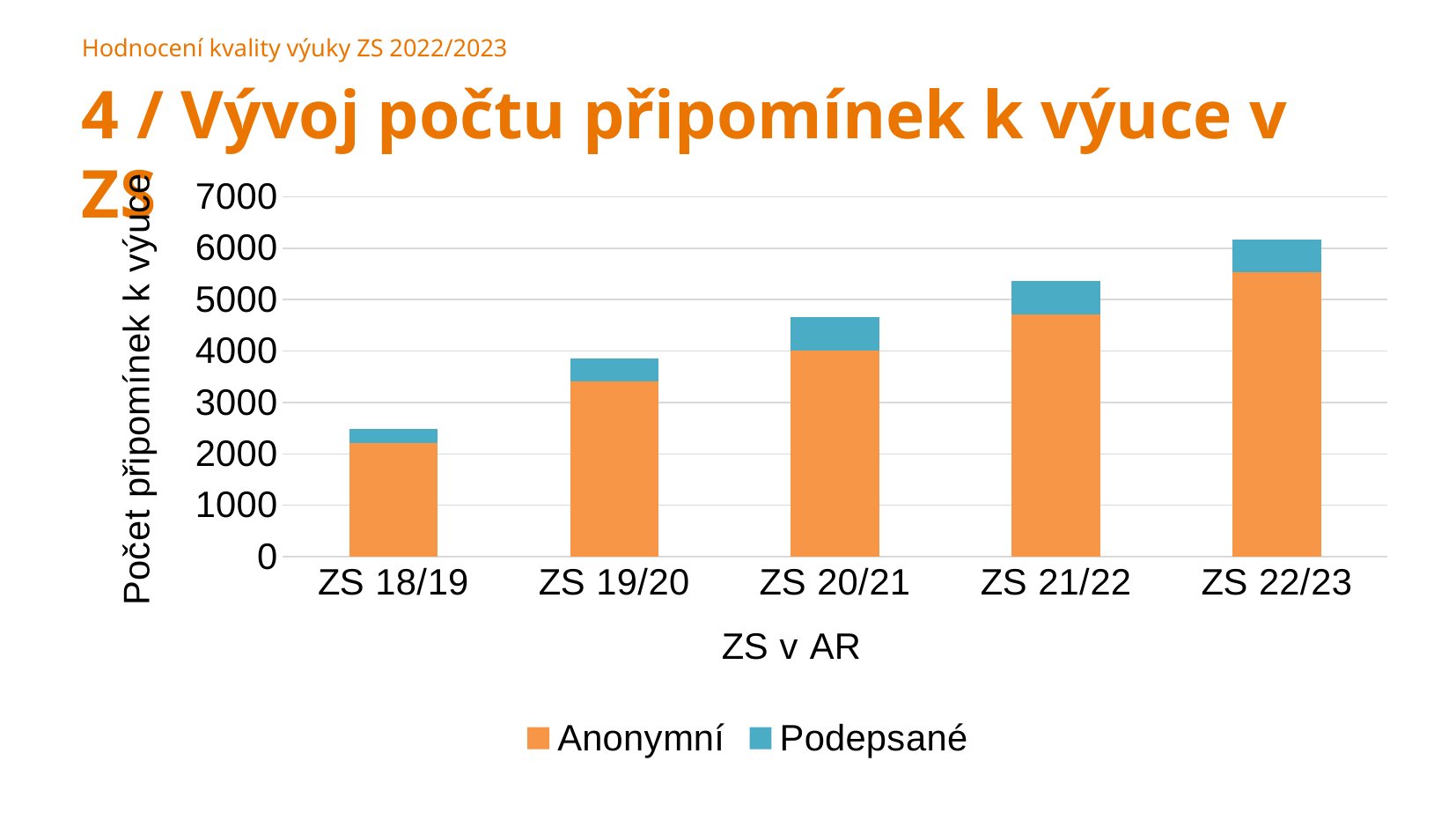
Is the total bar height for ZS 18/19 greater or less than 3000? less Is the Anonymní value for ZS 21/22 greater or less than 4000? greater How many series does the legend list? 2 What is the title of the y axis? Počet připomínek k výuce Which semester has the lowest total number of comments? ZS 18/19 In ZS 22/23, which series is larger, Anonymní or Podepsané? Anonymní Is the Anonymní value for ZS 22/23 greater or less than 5000? greater Which semester has the highest total number of comments? ZS 22/23 What kind of chart is shown on the slide? Stacked bar chart Do the total numbers of comments rise or fall from ZS 18/19 to ZS 22/23? Rise How many semesters (categories) are shown on the x axis? 5